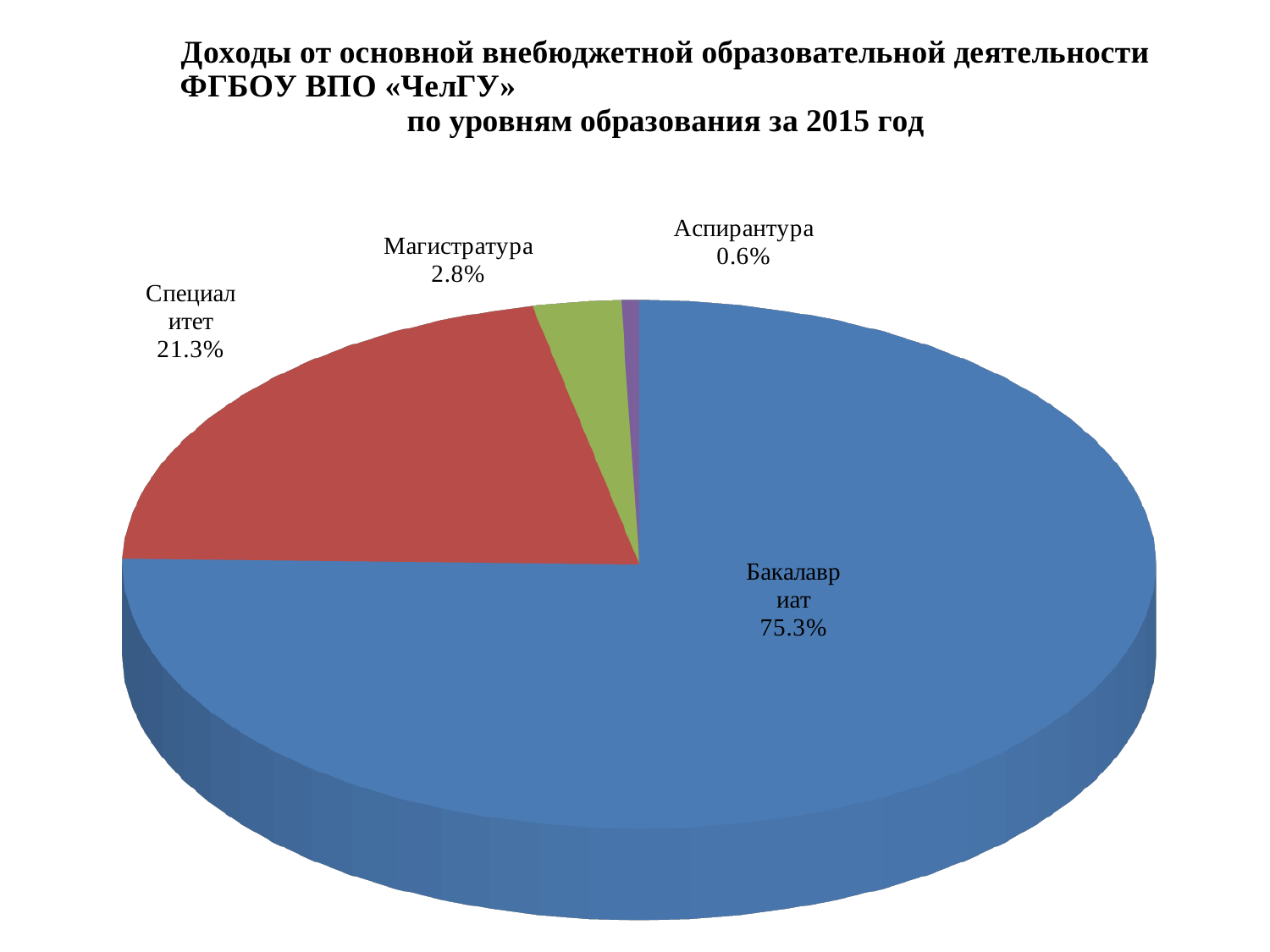
What kind of chart is shown on the slide? Pie chart What is the difference in percentage points between Магистратура and Аспирантура? 2.2 What is the value shown for Магистратура? 2.8% What is the difference in percentage points between Бакалавриат and Специалитет? 54.0 Which education level has the smallest share of income? Аспирантура What is the value shown for Аспирантура? 0.6% What share of the pie does Бакалавриат hold? 75.3% Which education level has the largest share of income? Бакалавриат What is the value shown for Специалитет? 21.3% Which is larger, the share for Специалитет or the share for Магистратура? Специалитет How many education levels (slices) are shown in the pie chart? 4 What colour is the slice for Специалитет? Red